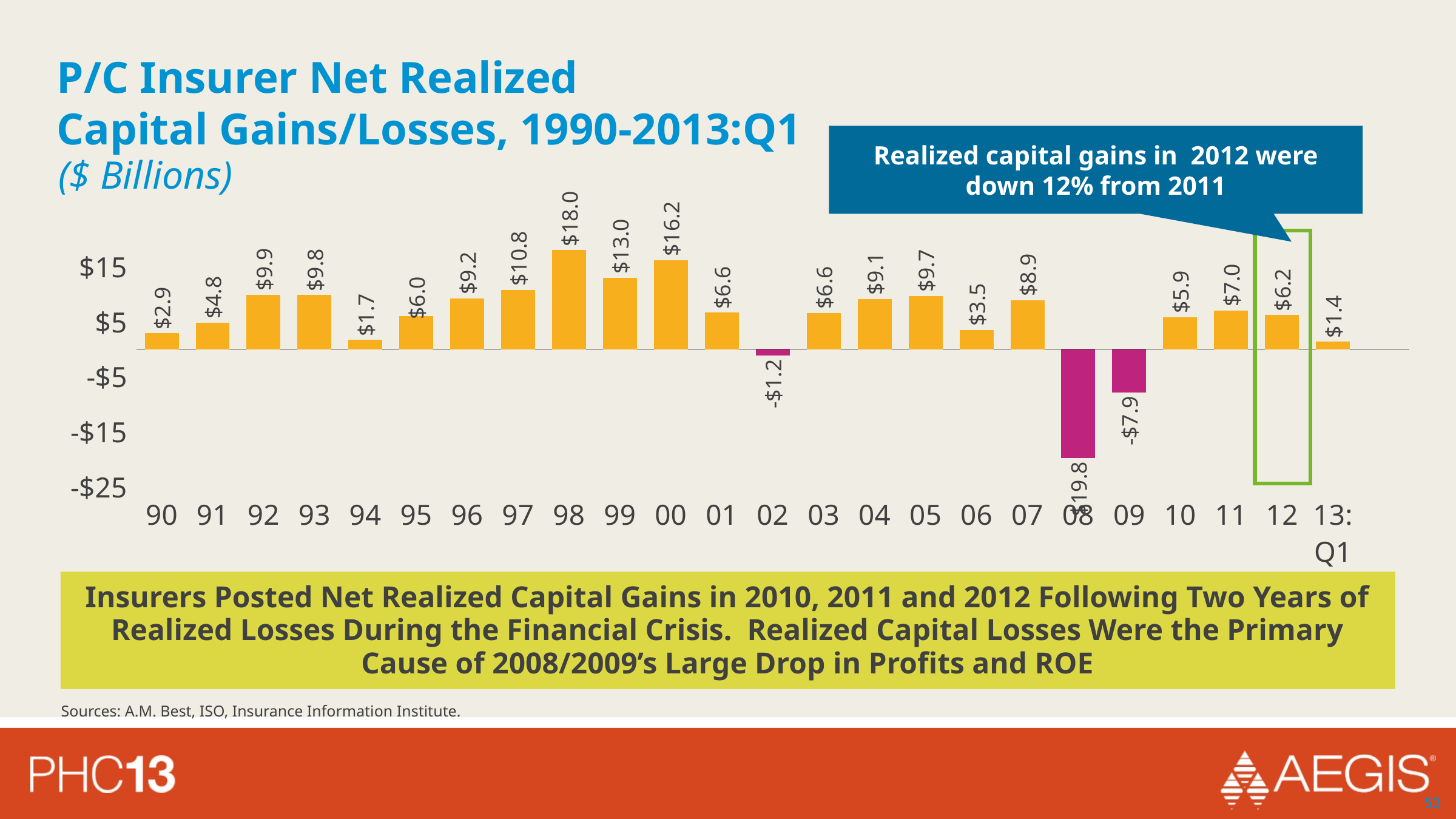
Which year had a larger net realized capital gain, 1999 or 2000? 2000 What was the net realized capital gain in 1998? $18.0 According to the callout, by what percentage were realized capital gains in 2012 down from 2011? 12% Which year had the highest net realized capital gain? 98 What was the net realized capital gain in 2012? $6.2 Which year had the lowest value (largest realized loss)? 08 How many years show a negative value (realized loss)? 3 What is the difference between the 2011 value ($7.0) and the 2012 value ($6.2)? $0.8 What type of chart is shown on the slide? bar chart How many years/periods are plotted on the x axis? 24 What was the net realized capital gain in 2013:Q1? $1.4 What was the net realized capital gain/loss in 2008? -$19.8